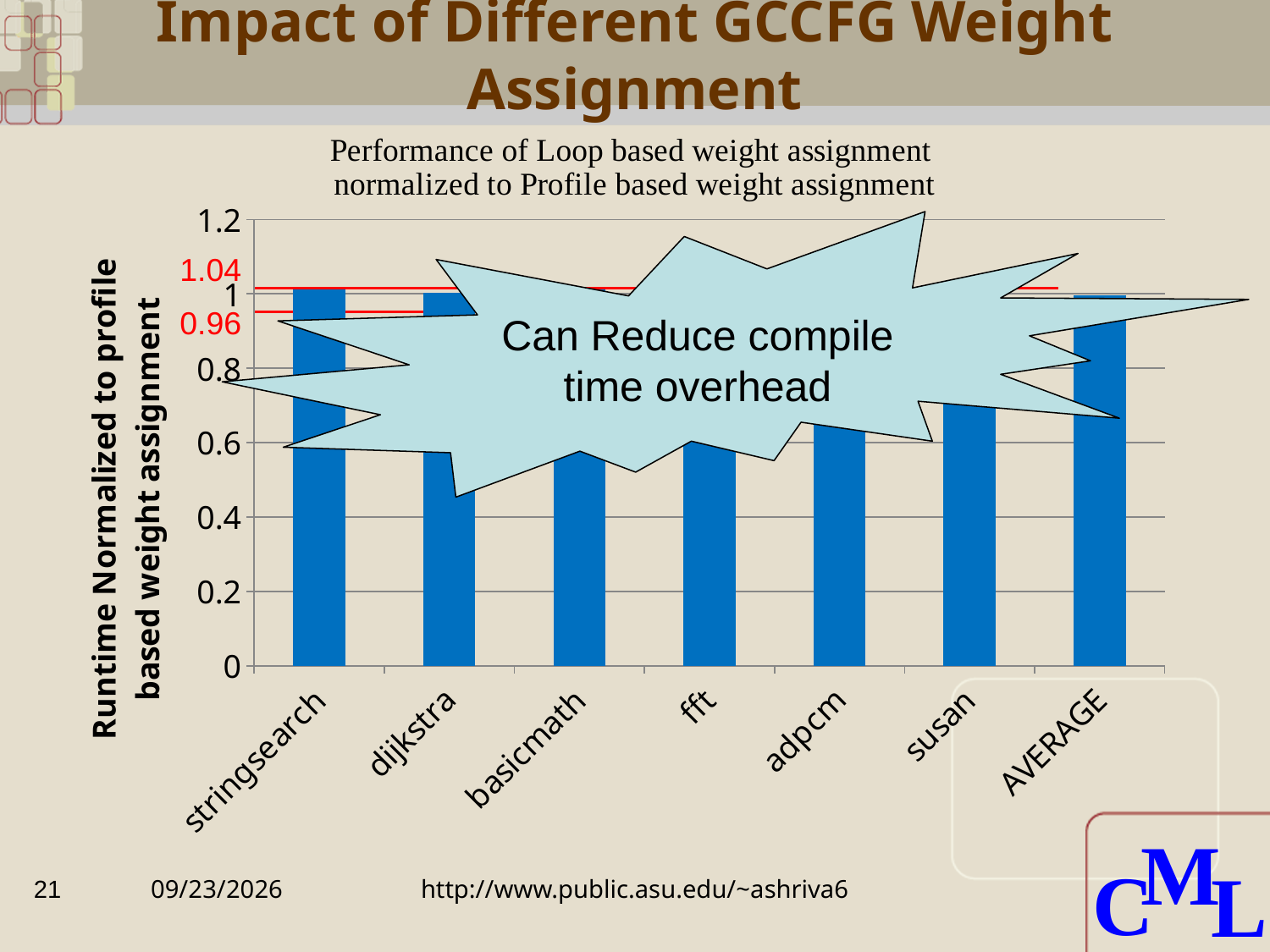
How many categories are shown on the x axis of the chart? 7 What is the label of the y axis? Runtime Normalized to profile based weight assignment Is the value for dijkstra greater or less than 0.8? greater Is the value for adpcm greater or less than 0.6? greater What is the title of the chart? Performance of Loop based weight assignment normalized to Profile based weight assignment What kind of chart is shown on the slide? bar chart Is the value for susan greater or less than 0.6? greater Which category is listed last on the x axis of the chart? AVERAGE